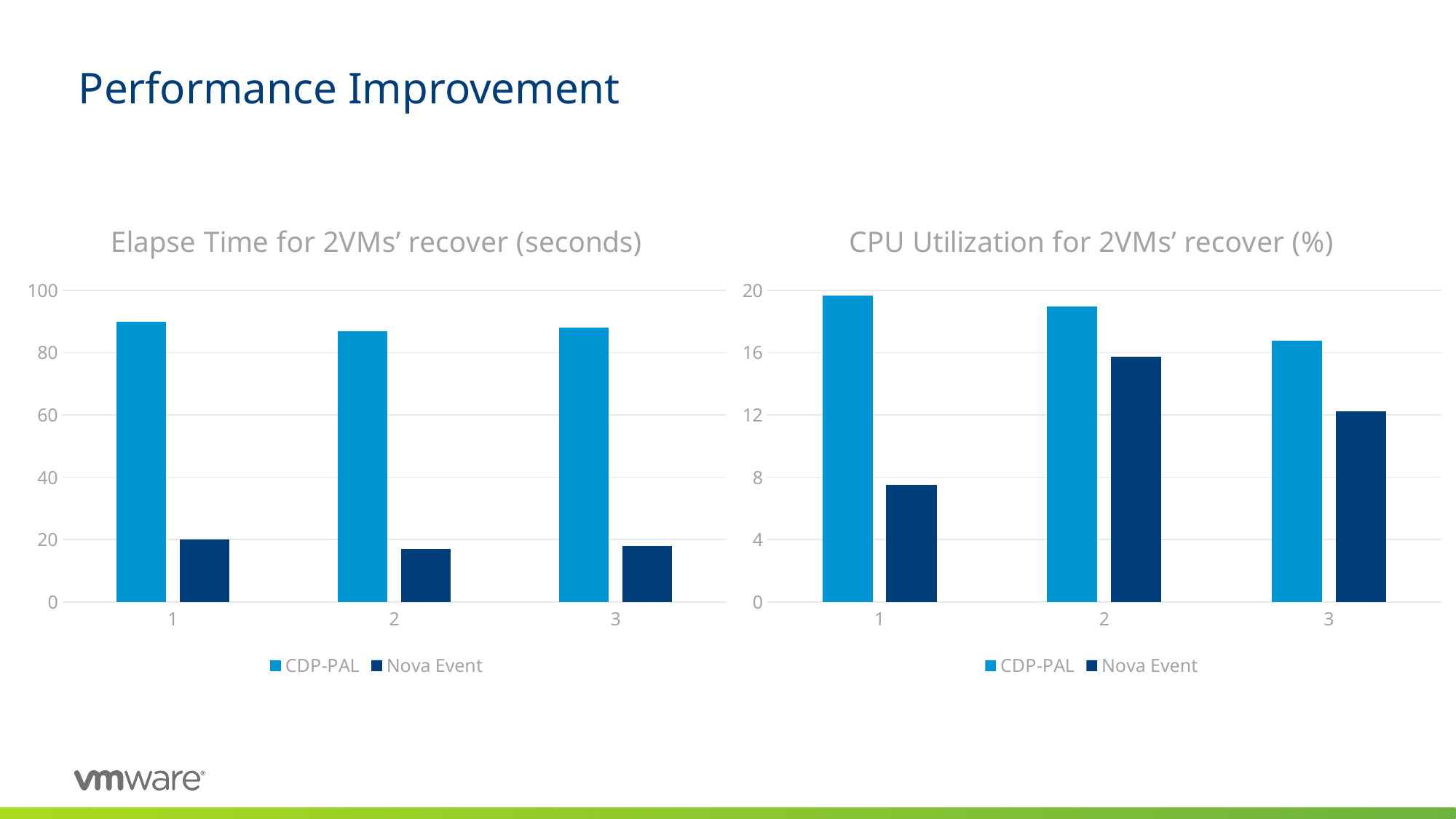
What are the two legend entries in the 'Elapse Time for 2VMs' recover (seconds)' chart? CDP-PAL and Nova Event In the 'CPU Utilization for 2VMs' recover (%)' chart, which category has the lowest Nova Event value? 1 In the 'CPU Utilization for 2VMs' recover (%)' chart, which category has the highest Nova Event value? 2 How many categories are shown on the x axis of the 'Elapse Time for 2VMs' recover (seconds)' chart? 3 How many series does the legend of the 'CPU Utilization for 2VMs' recover (%)' chart list? 2 In the 'Elapse Time for 2VMs' recover (seconds)' chart, is the CDP-PAL value for category 1 greater or less than 80? greater In the 'CPU Utilization for 2VMs' recover (%)' chart, which series has the larger value for category 3, CDP-PAL or Nova Event? CDP-PAL What kind of chart is the 'Elapse Time for 2VMs' recover (seconds)' chart? bar chart In the 'Elapse Time for 2VMs' recover (seconds)' chart, which series has the larger value for category 2, CDP-PAL or Nova Event? CDP-PAL In the 'CPU Utilization for 2VMs' recover (%)' chart, which category has the lowest CDP-PAL value? 3 In the 'Elapse Time for 2VMs' recover (seconds)' chart, is the Nova Event value for category 2 greater or less than 20? less